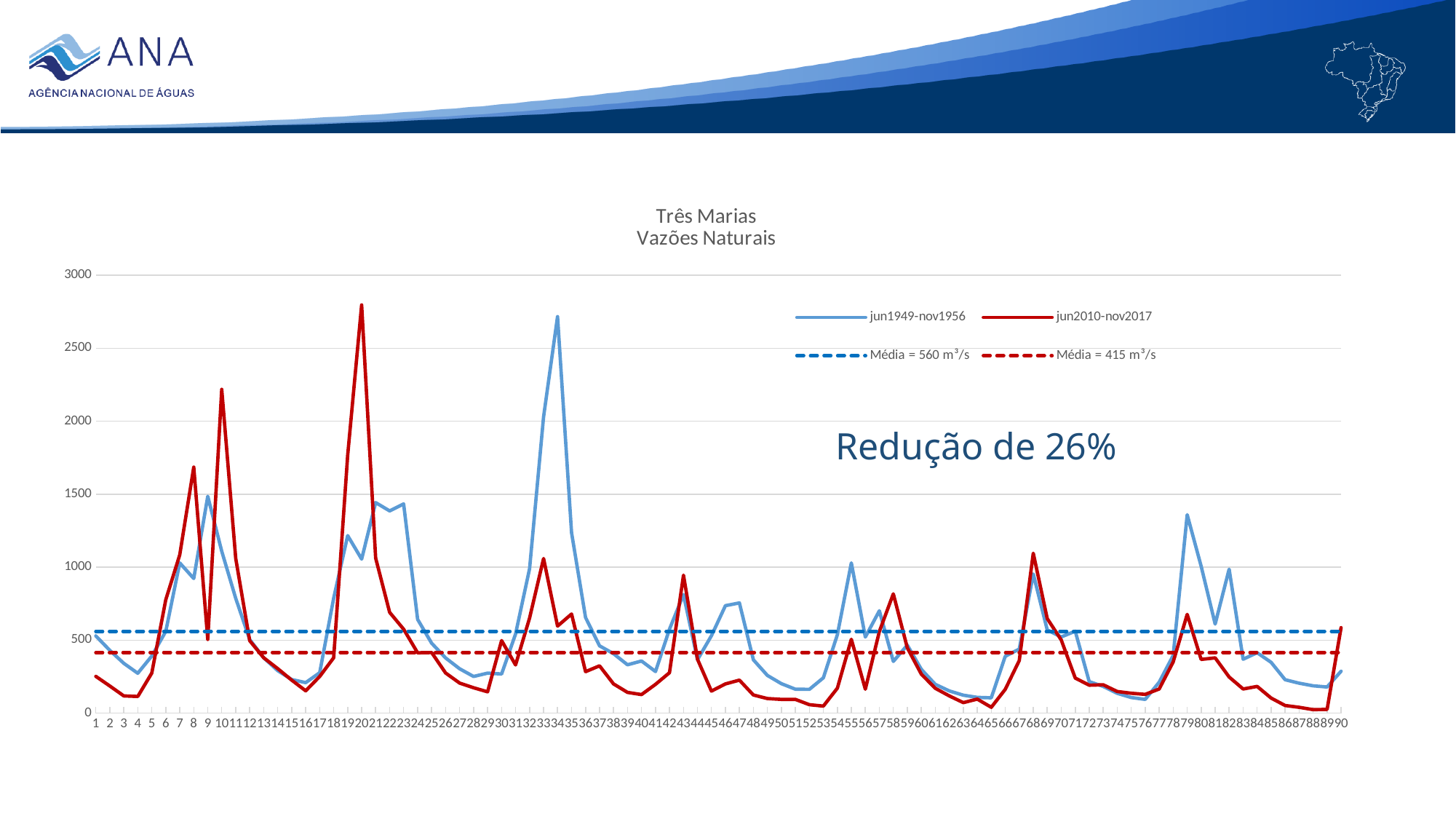
How many series does the legend list? 4 How many points are there along the x axis? 90 Which period has the higher mean value, jun1949-nov1956 or jun2010-nov2017? jun1949-nov1956 What kind of chart is shown on the slide? line chart At point 34, which series has the higher value, jun1949-nov1956 or jun2010-nov2017? jun1949-nov1956 Is the value for jun1949-nov1956 at point 20 greater or less than 1500? less What is the value of the blue dashed mean line (Média) for the jun1949-nov1956 period? 560 m³/s What is the title of the chart? Três Marias Vazões Naturais Is the value for jun2010-nov2017 at point 20 greater or less than 2500? greater What is the difference between the two mean values shown in the legend (560 m³/s and 415 m³/s)? 145 m³/s What is the value of the red dashed mean line (Média) for the jun2010-nov2017 period? 415 m³/s Is the value for jun1949-nov1956 at point 34 greater or less than 2500? greater